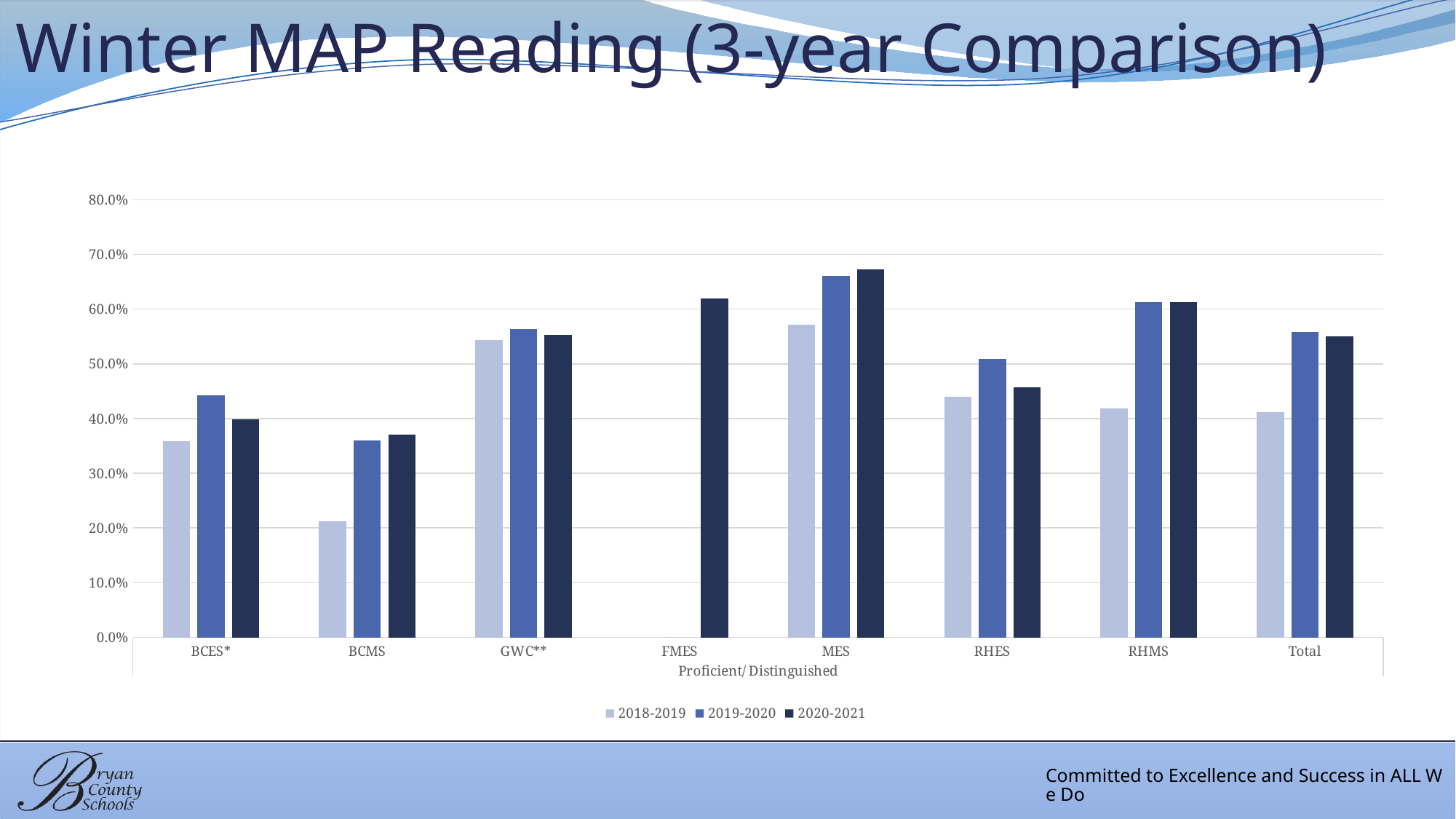
Which category has the highest 2020-2021 value? MES For RHES, which is larger: the 2019-2020 value or the 2020-2021 value? 2019-2020 For BCES*, which is larger: the 2019-2020 value or the 2020-2021 value? 2019-2020 Do the values for BCMS rise or fall from 2018-2019 to 2020-2021? rise Which category has the lowest 2018-2019 value? BCMS How many categories are shown along the x axis? 8 How many series does the legend list? 3 Is the 2020-2021 value for MES greater or less than 60.0%? greater Which category has a bar for only one of the three years? FMES Is the 2018-2019 value for BCMS greater or less than 30.0%? less What kind of chart is shown on the slide? Bar chart Is the 2020-2021 value for FMES greater or less than 50.0%? greater